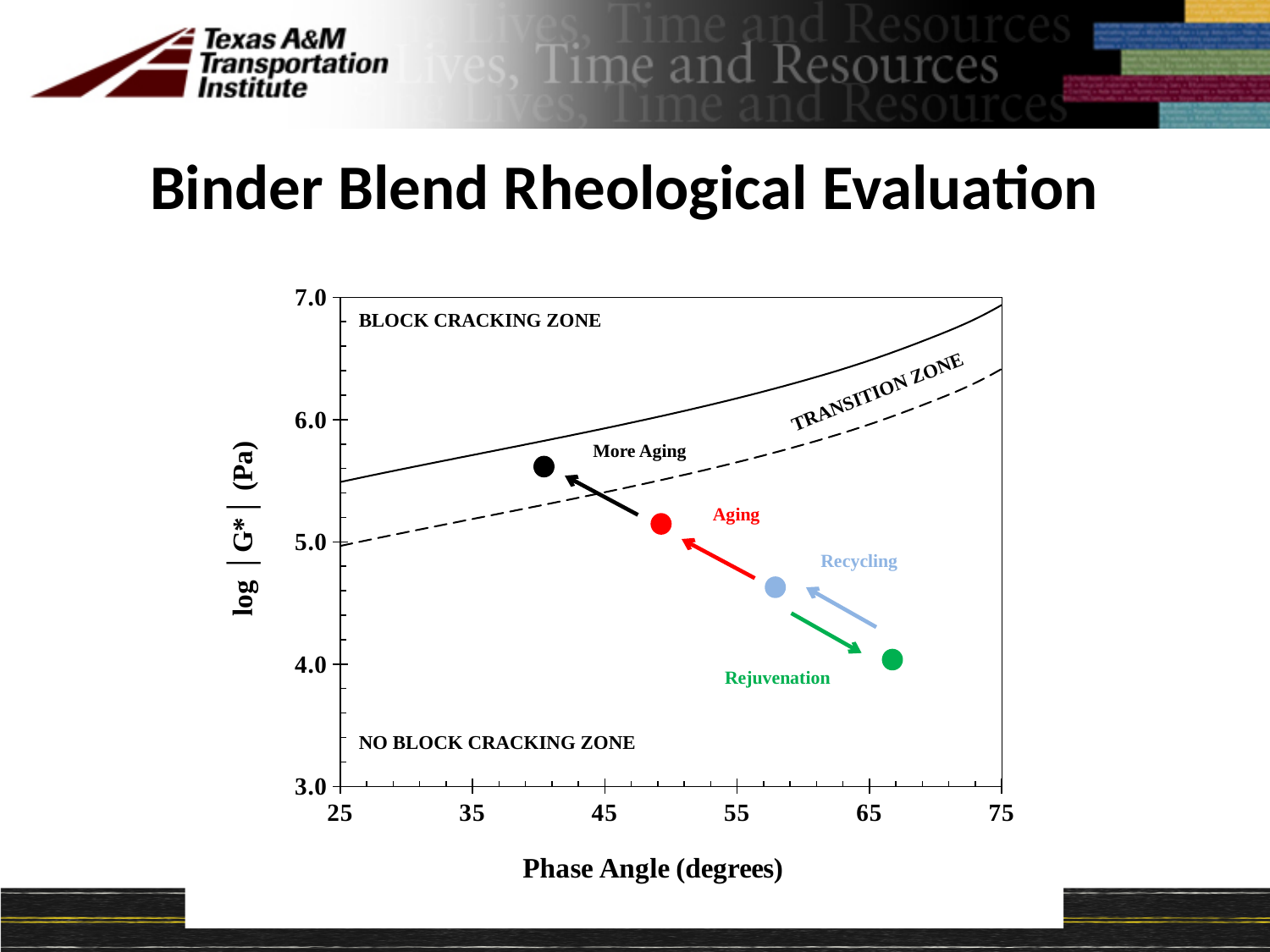
Is the log |G*| value for the Rejuvenation (green) point greater or less than 5.0? less How many data points are plotted on the chart? 4 Which plotted point has the largest phase angle? Rejuvenation (green point) Is the log |G*| value for the More Aging (black) point greater or less than 5.0? greater What is the label of the x axis? Phase Angle (degrees) Which plotted point has the highest log |G*| value? More Aging (black point) Which plotted point has the lowest log |G*| value? Rejuvenation (green point) Which has a higher log |G*| value, the Aging (red) point or the Recycling (light blue) point? Aging (red) point Is the phase angle of the More Aging (black) point greater or less than 45 degrees? less What kind of chart is shown on the slide? Scatter chart As the phase angle increases along the x axis, do the plotted points' log |G*| values rise or fall? fall